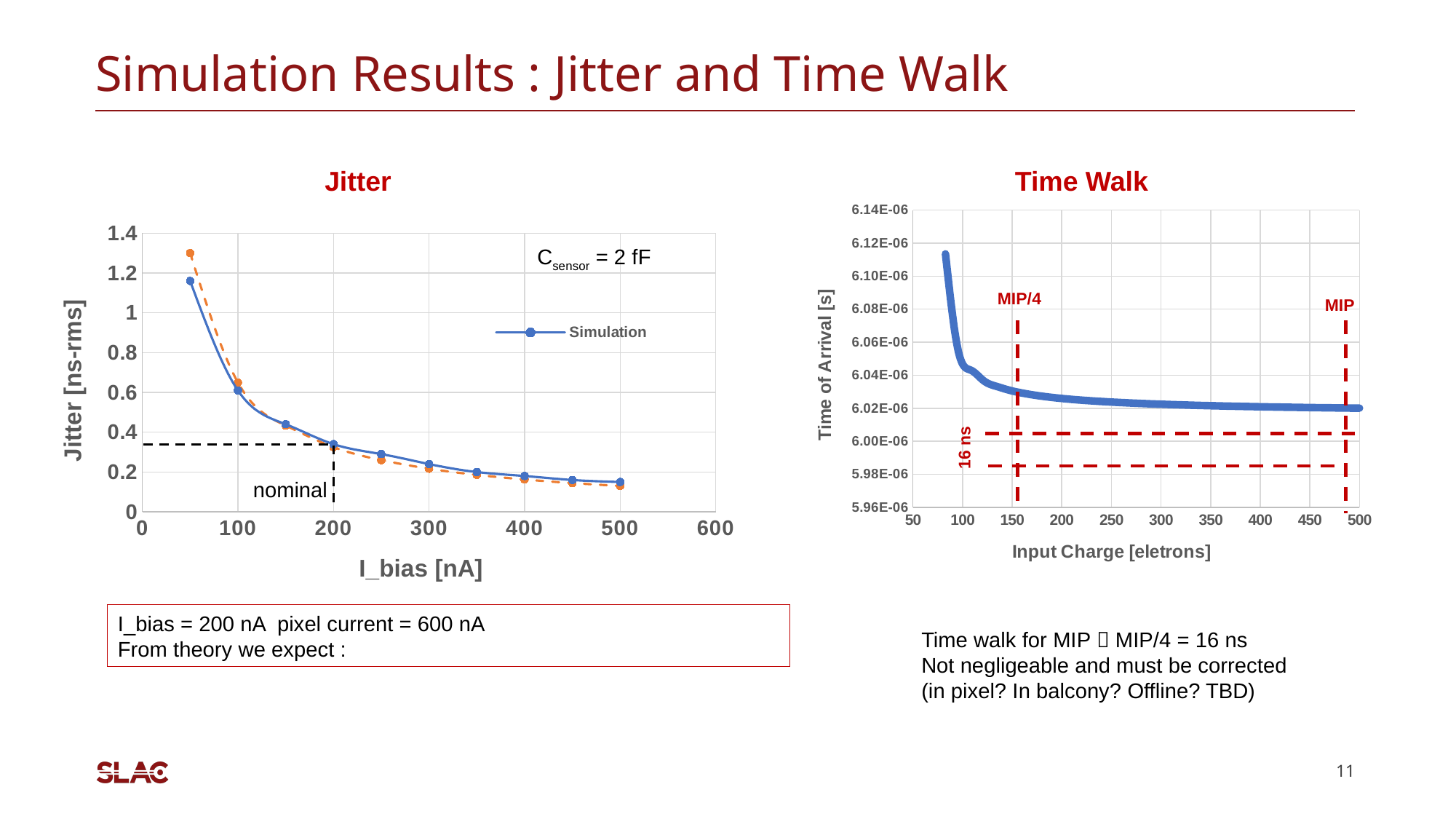
In the Jitter chart, does the jitter rise or fall as I_bias increases? fall In the Jitter chart, is the Simulation jitter at I_bias = 500 nA greater or less than 0.2? less In the Time Walk chart, is the time of arrival at an input charge of 500 electrons greater or less than 6.04E-06? less In the Time Walk chart, does the time of arrival rise or fall as input charge increases? fall How many series does the legend of the Jitter chart list? 1 How many data points does the Simulation series in the Jitter chart have? 10 In the Jitter chart, is the Simulation jitter at I_bias = 100 nA greater or less than 0.8? less In the Jitter chart, what is the name of the series shown in the legend? Simulation In the Jitter chart, at which I_bias value is the Simulation jitter highest? 50 What type of chart is the Jitter chart? line chart In the Jitter chart, at which I_bias value is the Simulation jitter lowest? 500